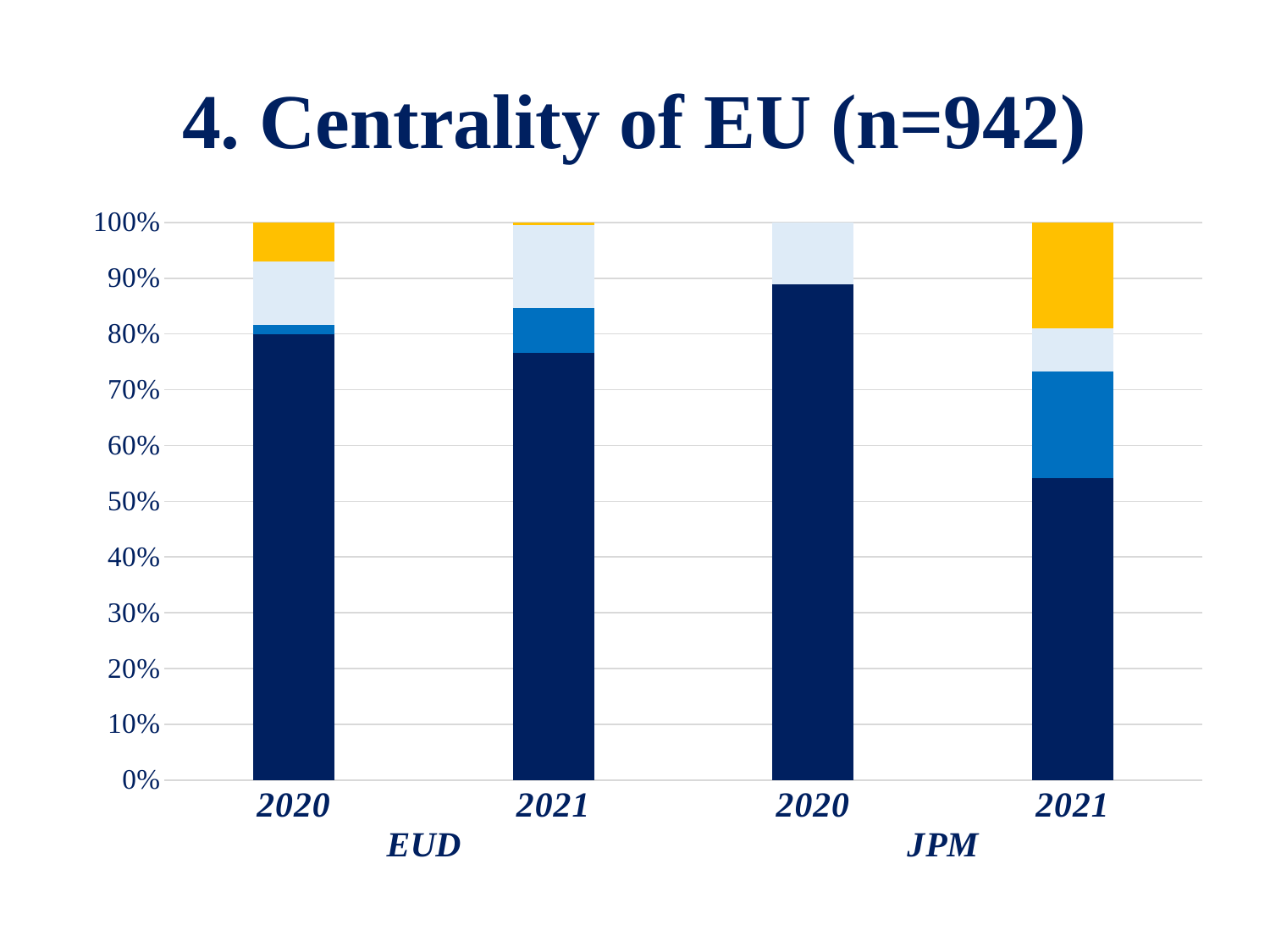
Is the top of the dark navy segment for EUD 2021 greater or less than 70%? greater What kind of chart is shown on the slide? Stacked bar chart Is the dark navy segment larger for JPM 2020 or JPM 2021? JPM 2020 Which two groups are the bars divided into along the x axis? EUD and JPM How many bars are plotted in the chart? 4 Is the top of the dark navy segment for JPM 2020 greater or less than 80%? greater Which bar has the largest dark navy (bottom) segment? JPM 2020 Is the top of the dark navy segment for JPM 2021 greater or less than 60%? less What is the total height of each stacked bar? 100% Which bar has the largest yellow segment? JPM 2021 Which bar has the smallest dark navy (bottom) segment? JPM 2021 What is the title of the chart on the slide? 4. Centrality of EU (n=942)